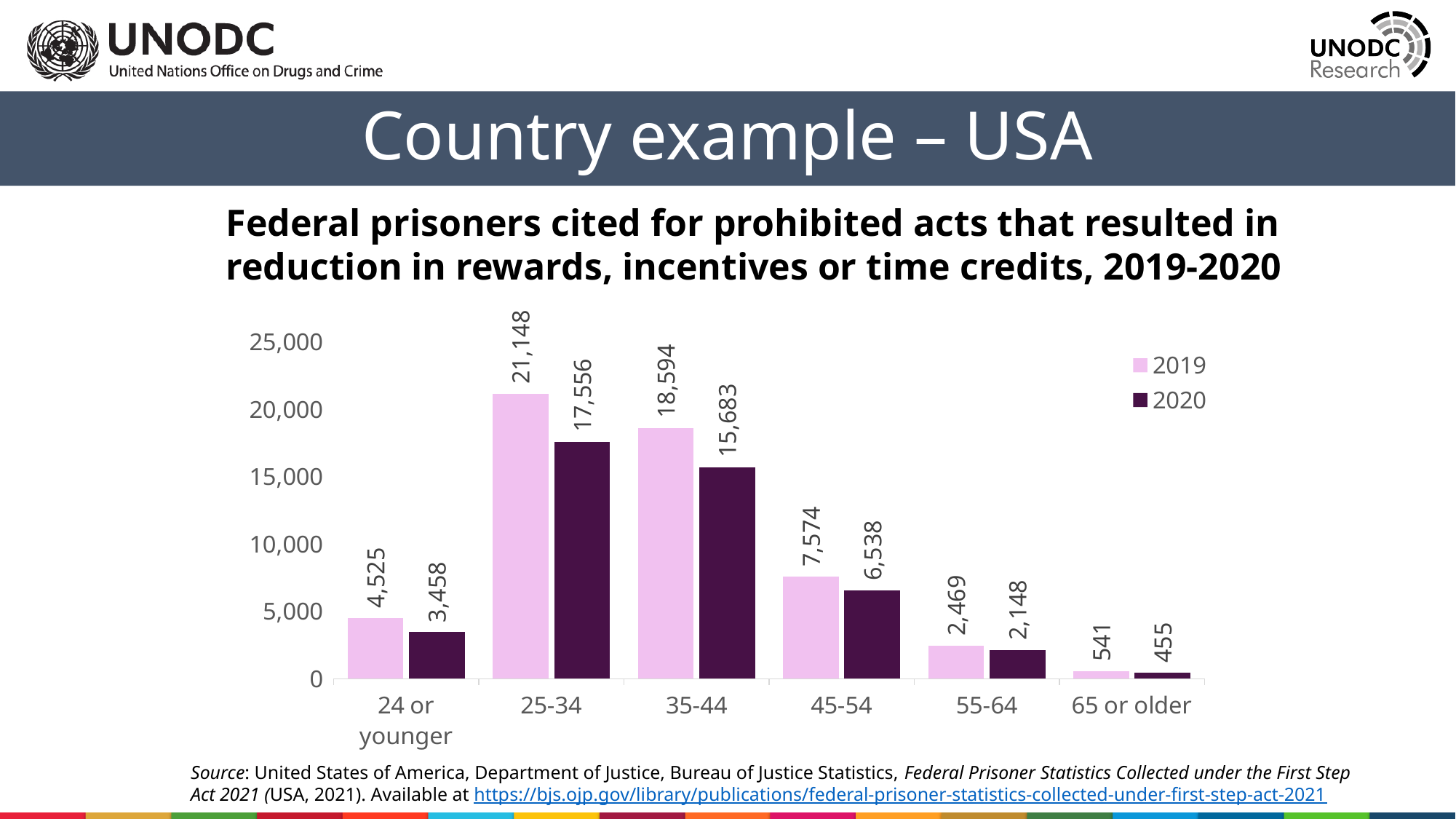
What kind of chart is shown on the slide? Bar chart Which age group has the lowest 2019 value? 65 or older Is the 2020 value for the 25-34 age group greater or less than 15,000? greater How many age groups are shown on the x axis? 6 What is the 2020 value for the 45-54 age group? 6,538 Which colour represents the 2020 series in the chart? Dark purple What is the 2019 value for the 25-34 age group? 21,148 What is the 2019 value for the 65 or older age group? 541 What is the difference between the 2019 and 2020 values for the 35-44 age group? 2,911 How many series does the legend list? 2 Which age group has the highest 2020 value? 25-34 Which is larger for the 55-64 age group, the 2019 value or the 2020 value? 2019